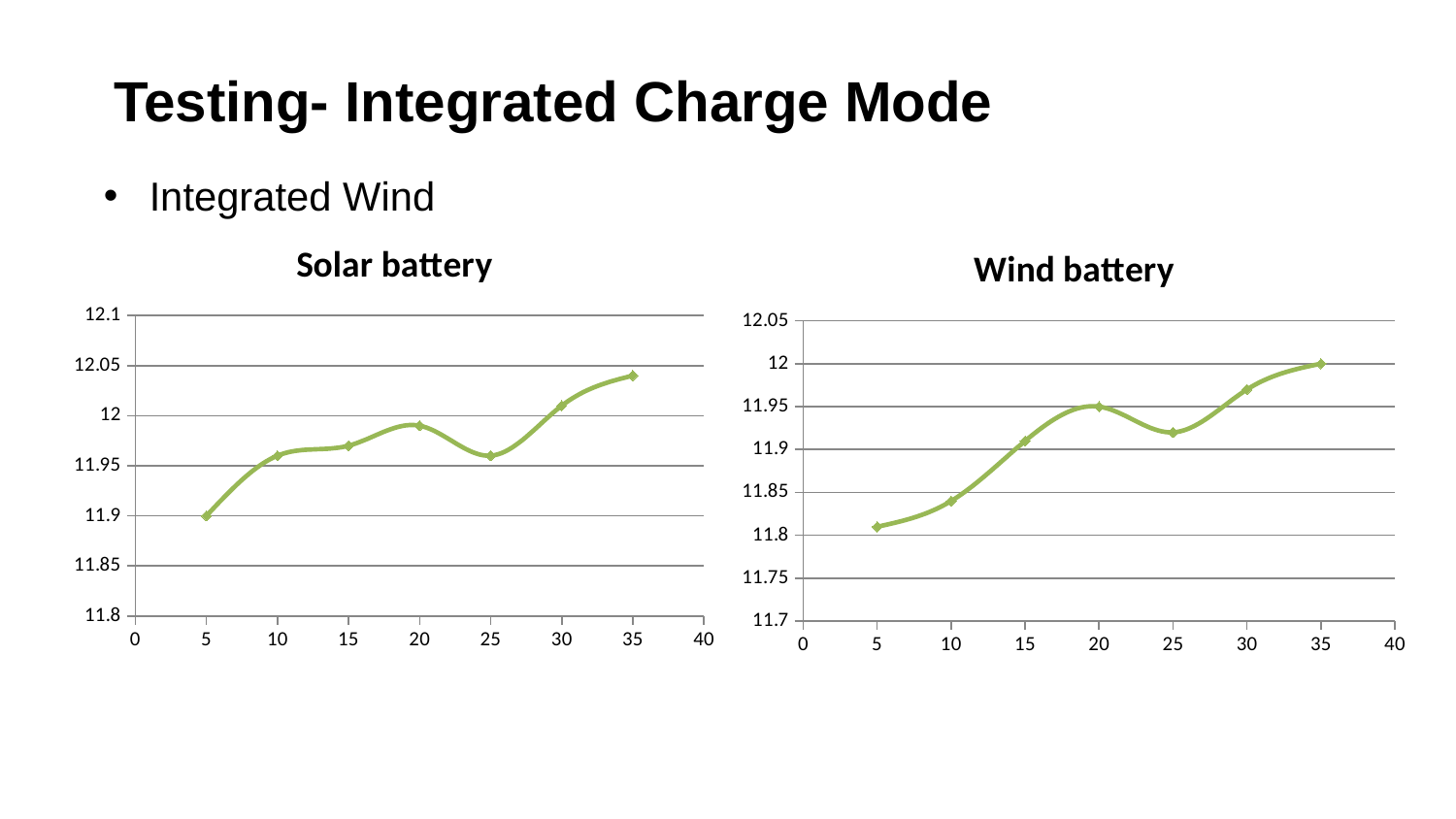
On the Wind battery chart, at which x value is the plotted value lowest? 5 On the Wind battery chart, what is the value at x = 20? 11.95 On the Solar battery chart, is the value at x = 35 greater or less than 12? greater On the Wind battery chart, is the value at x = 30 greater or less than 11.95? greater What kind of chart is the Solar battery chart? Line chart On the Wind battery chart, what is the value at x = 35? 12 How many data points are plotted on the Wind battery chart? 7 On the Solar battery chart, at which x value is the plotted value highest? 35 On the Wind battery chart, do the values generally rise or fall as x increases? Rise On the Wind battery chart, is the value at x = 25 greater or less than 11.95? less On the Solar battery chart, which is larger, the value at x = 20 or the value at x = 25? x = 20 On the Solar battery chart, what is the value at x = 5? 11.9